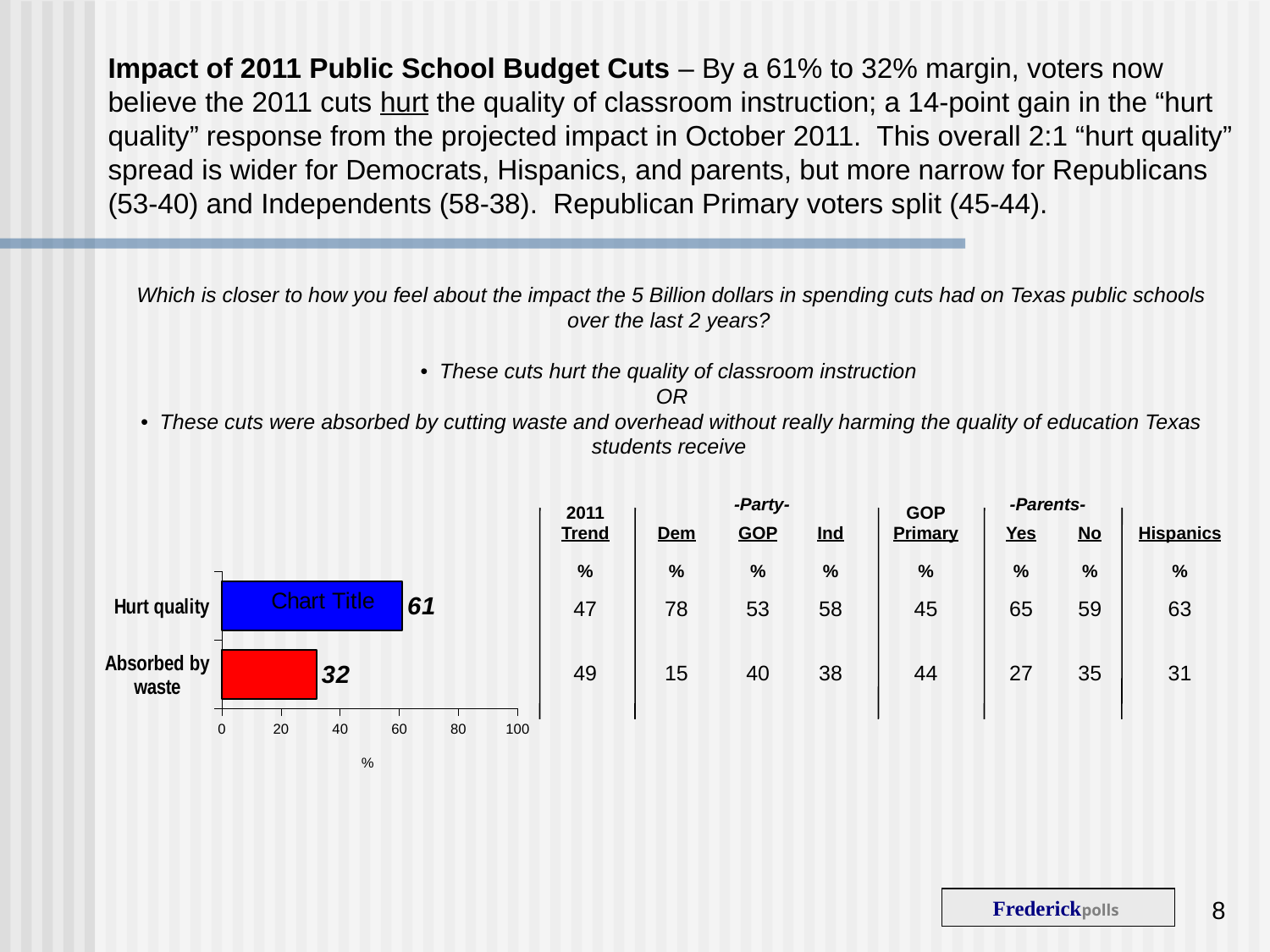
How many categories are shown in the bar chart? 2 What is the difference between the Hurt quality value and the Absorbed by waste value in the bar chart? 29 What is the value for Absorbed by waste in the bar chart? 32 What kind of chart is shown on the slide? bar chart What is the value for Hurt quality in the bar chart? 61 Is the value for Hurt quality greater or less than 40? greater Which is larger in the bar chart, Hurt quality or Absorbed by waste? Hurt quality Which category has the highest value in the bar chart? Hurt quality What colour is the bar for Hurt quality? blue What is the maximum value shown on the chart's horizontal axis? 100 Which category has the lowest value in the bar chart? Absorbed by waste Is the value for Absorbed by waste greater or less than 40? less